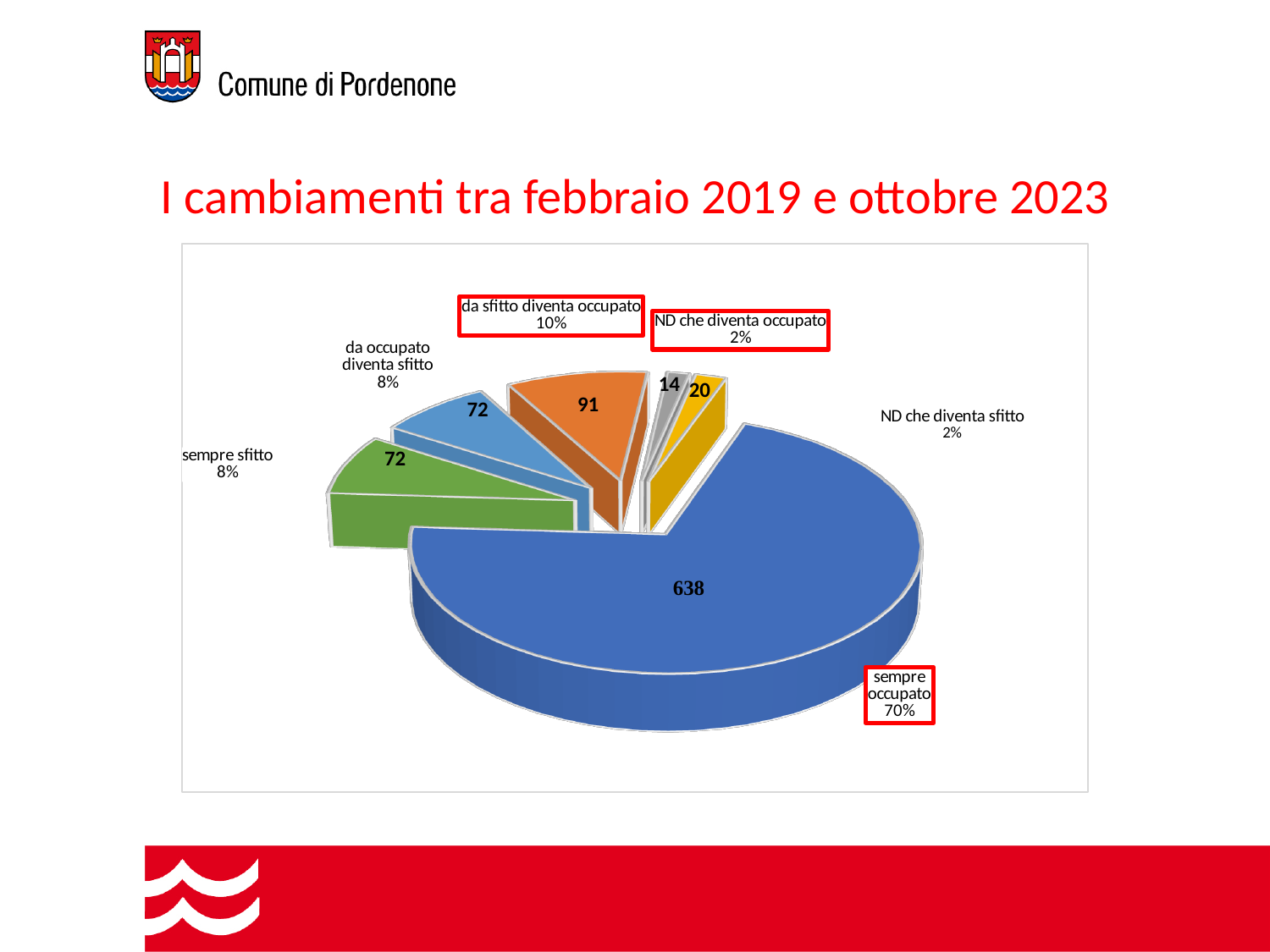
Which category has the largest slice of the pie? sempre occupato What percentage share does the 'sempre occupato' slice have? 70% What is the value shown for the 'da sfitto diventa occupato' slice? 91 What percentage share does the 'sempre sfitto' slice have? 8% What is the title of the slide containing the chart? I cambiamenti tra febbraio 2019 e ottobre 2023 What kind of chart is shown on the slide? pie chart How many slices does the pie chart have? 6 What is the difference between the 'sempre occupato' value and the 'da sfitto diventa occupato' value? 547 What is the difference between the 'da sfitto diventa occupato' value and the 'sempre sfitto' value? 19 What percentage share does the 'da sfitto diventa occupato' slice have? 10% What is the value shown for the 'sempre occupato' slice? 638 Which is larger, the 'sempre occupato' slice or the 'da sfitto diventa occupato' slice? sempre occupato